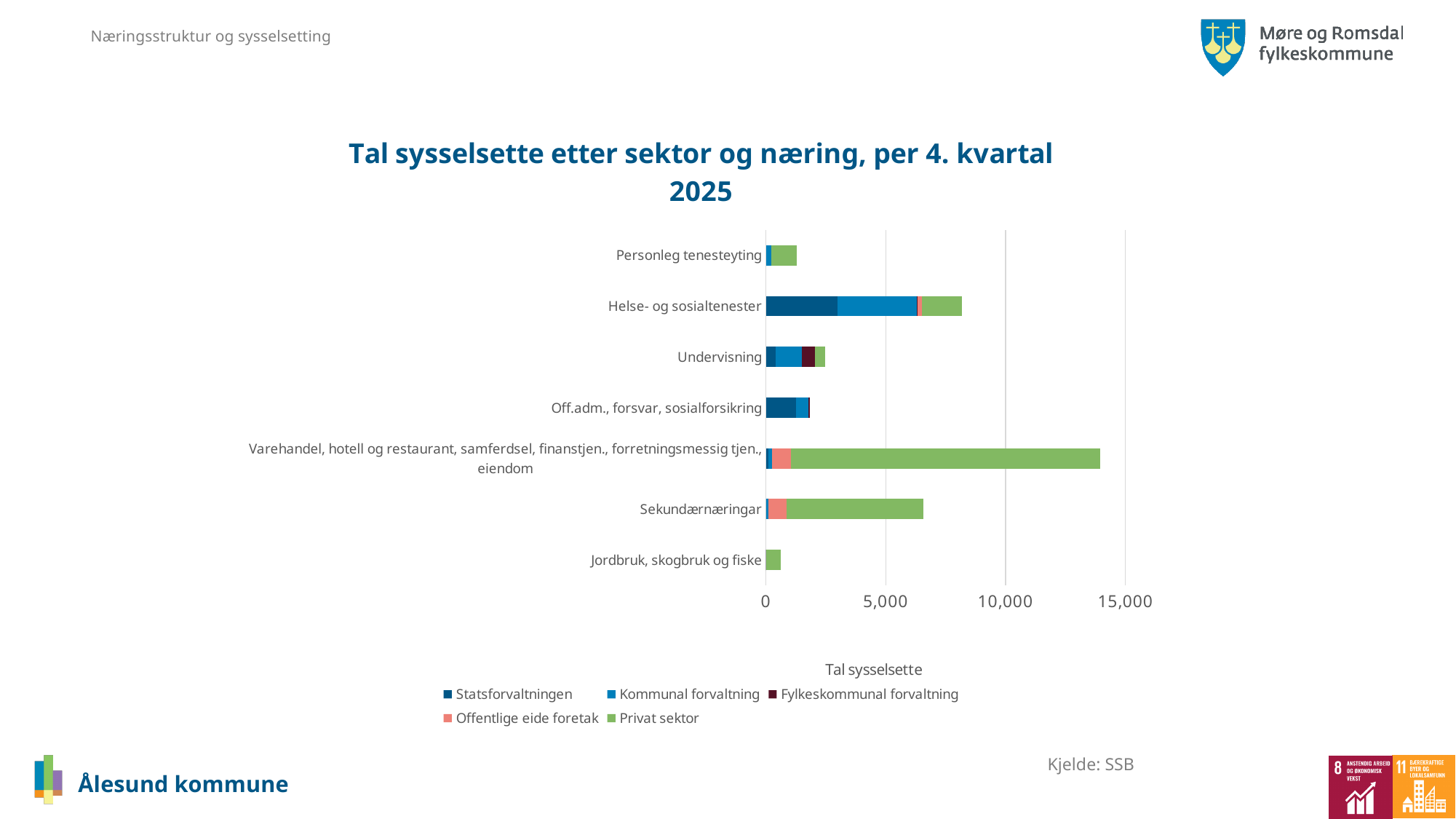
What kind of chart is shown on the slide? Stacked bar chart Is the total value for Helse- og sosialtenester greater or less than 5,000? greater Is the total value for Sekundærnæringar greater or less than 5,000? greater How many series does the chart legend list? 5 How many industry categories are shown on the y axis of the chart? 7 Which category has the shortest total bar in the chart? Jordbruk, skogbruk og fiske Which has a larger total bar: Personleg tenesteyting or Jordbruk, skogbruk og fiske? Personleg tenesteyting Which has a larger total bar: Helse- og sosialtenester or Sekundærnæringar? Helse- og sosialtenester Which category has the longest total bar in the chart? Varehandel, hotell og restaurant, samferdsel, finanstjen., forretningsmessig tjen., eiendom Is the total value for Undervisning greater or less than 5,000? less What is the title of the chart? Tal sysselsette etter sektor og næring, per 4. kvartal 2025